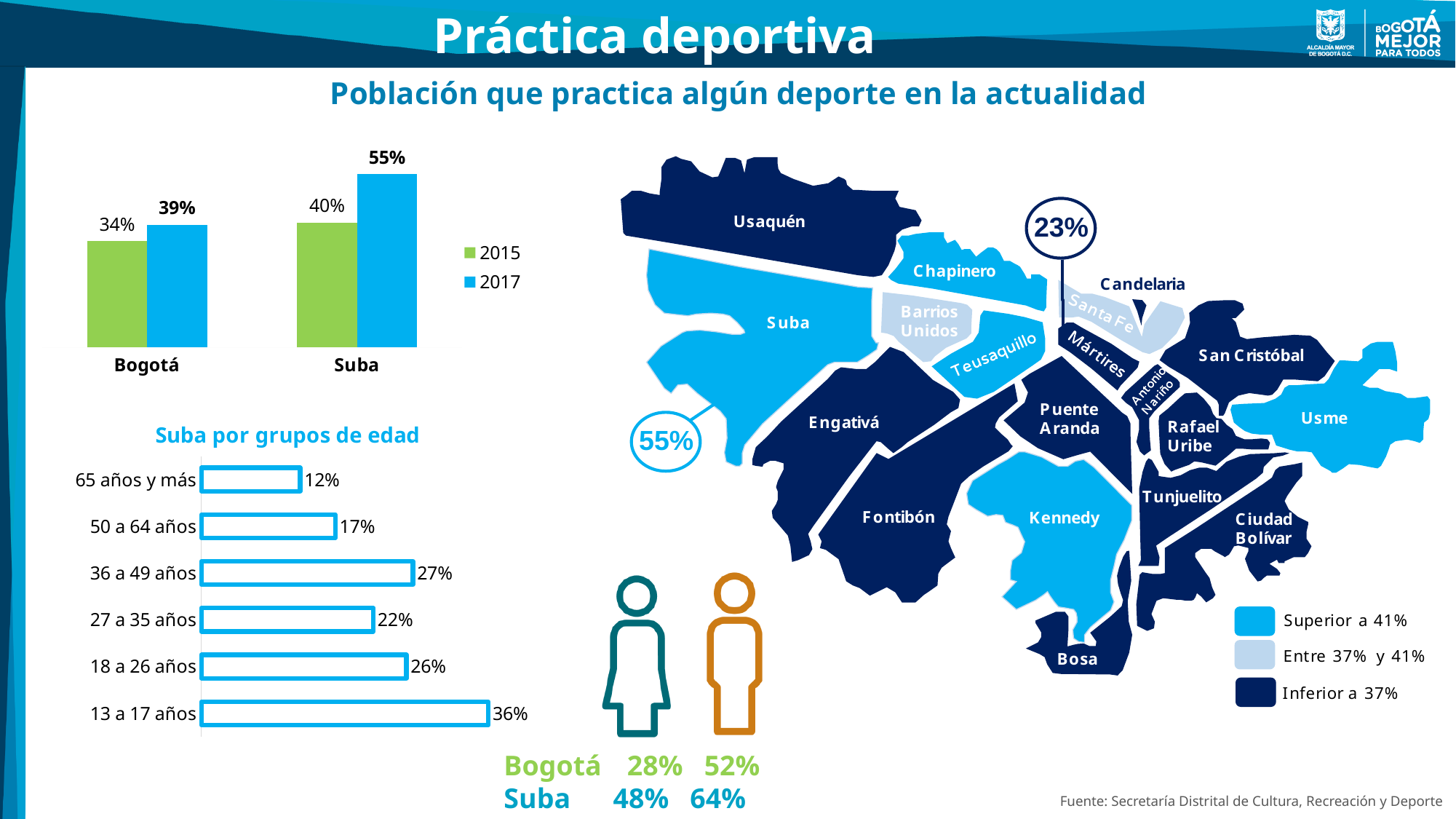
In the chart 'Suba por grupos de edad', what is the difference between the values for 36 a 49 años and 27 a 35 años? 5% In the bar chart at the top left comparing Bogotá and Suba, what is the 2017 value for Suba? 55% In the chart 'Suba por grupos de edad', how many age groups are shown? 6 In the chart 'Suba por grupos de edad', which age group has the lowest value? 65 años y más In the chart 'Suba por grupos de edad', what is the value for 13 a 17 años? 36% In the bar chart at the top left comparing Bogotá and Suba, what is the difference between Suba's 2017 and 2015 values? 15% In the bar chart at the top left comparing Bogotá and Suba, what is the 2015 value for Bogotá? 34% In the chart 'Suba por grupos de edad', which age group has the highest value? 13 a 17 años In the bar chart at the top left comparing Bogotá and Suba, which is larger: Bogotá's 2017 value or Suba's 2015 value? Suba's 2015 value In the bar chart at the top left comparing Bogotá and Suba, how many series does the legend list? 2 What type of chart is 'Suba por grupos de edad'? Bar chart In the bar chart at the top left comparing Bogotá and Suba, which colour represents 2015? Green